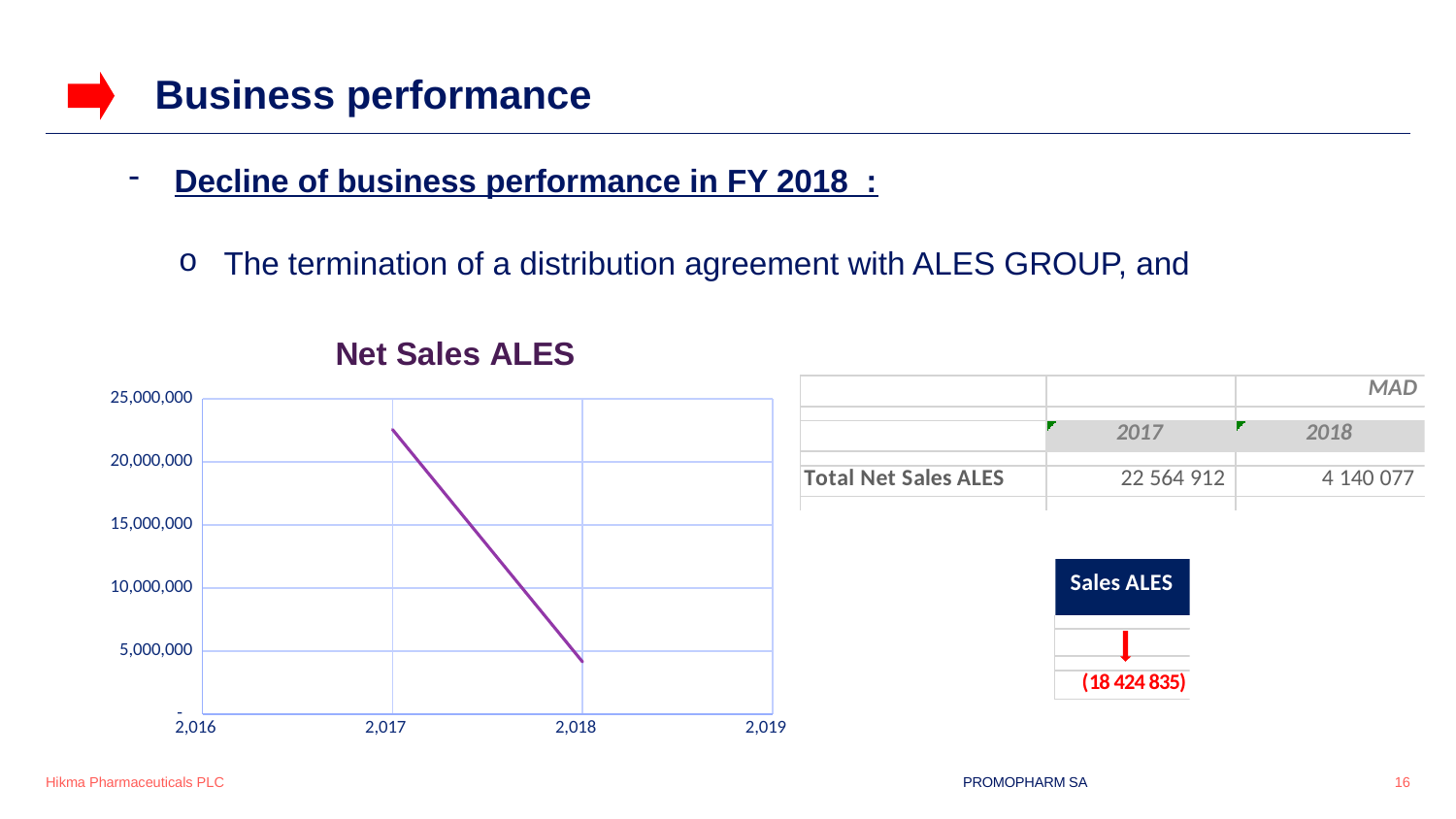
Which year has the lowest value in the Net Sales ALES chart? 2018 What is the Total Net Sales ALES for 2017 as shown on the slide? 22 564 912 Which year has the highest value in the Net Sales ALES chart? 2017 What is the Total Net Sales ALES for 2018 as shown on the slide? 4 140 077 What kind of chart is shown on the slide? line chart In the Net Sales ALES chart, is the value for 2017 greater or less than 20,000,000? greater In the Net Sales ALES chart, is the value for 2018 greater or less than 5,000,000? less What is the title of the chart on the slide? Net Sales ALES Do the values in the Net Sales ALES chart rise or fall from 2017 to 2018? fall How many data points are plotted on the line in the Net Sales ALES chart? 2 By how much did Net Sales ALES change from 2017 to 2018, as shown on the slide? (18 424 835) In the Net Sales ALES chart, which year has the higher value, 2017 or 2018? 2017